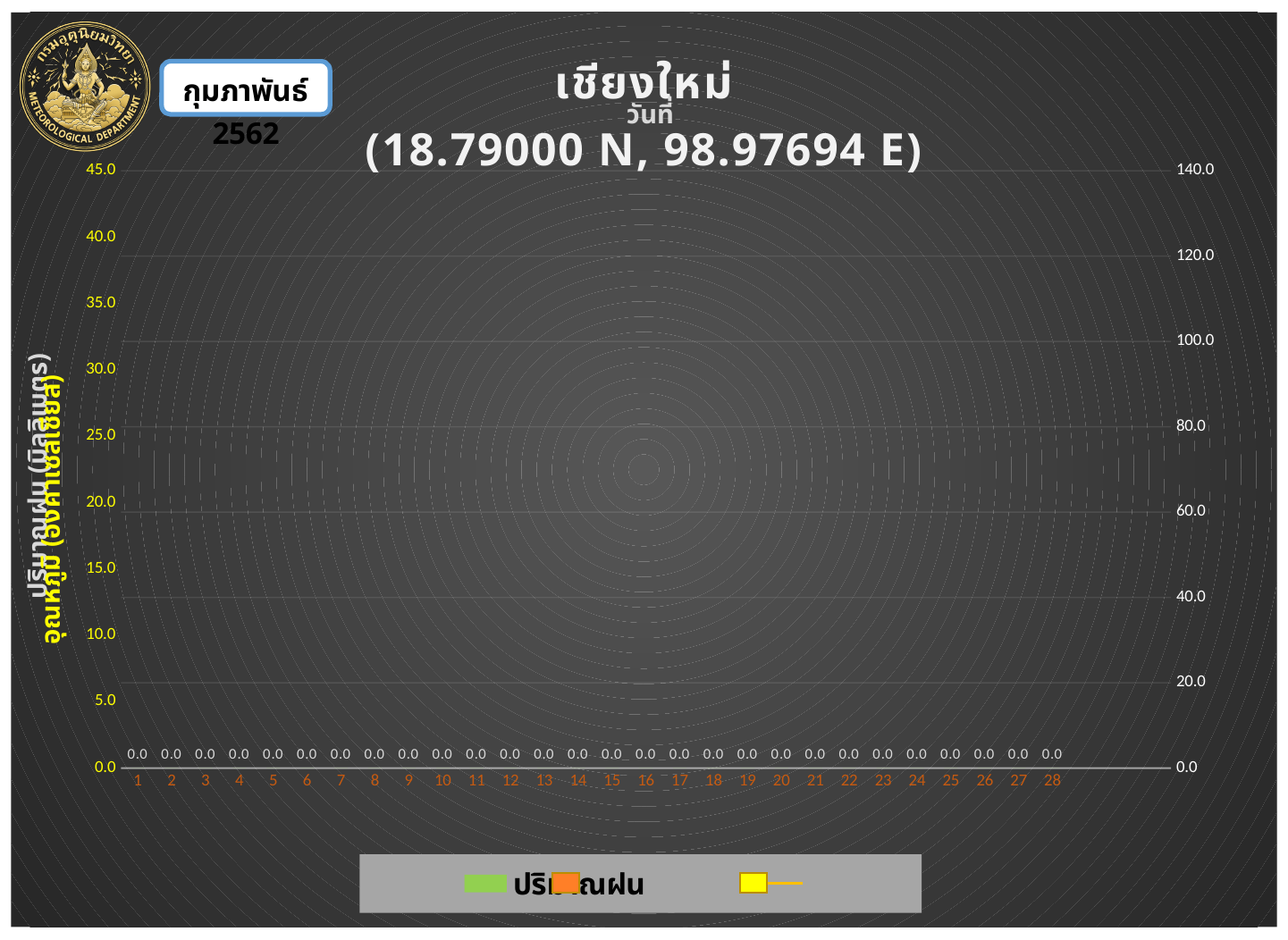
What is the highest value shown on the left vertical axis? 45.0 How many days are shown on the x axis of the chart? 28 What is the first day number shown on the x axis? 1 Do the data labels rise, fall, or stay the same from day 1 to day 28? stay the same What is the last day number shown on the x axis? 28 What is the data label shown for day 28? 0.0 What is the highest value shown on the right vertical axis? 140.0 Is the data label for day 5 greater or less than 5.0 on the left axis? less What is the difference between the data labels for day 10 and day 20? 0.0 What is the data label shown for day 15? 0.0 What is the data label shown for day 1? 0.0